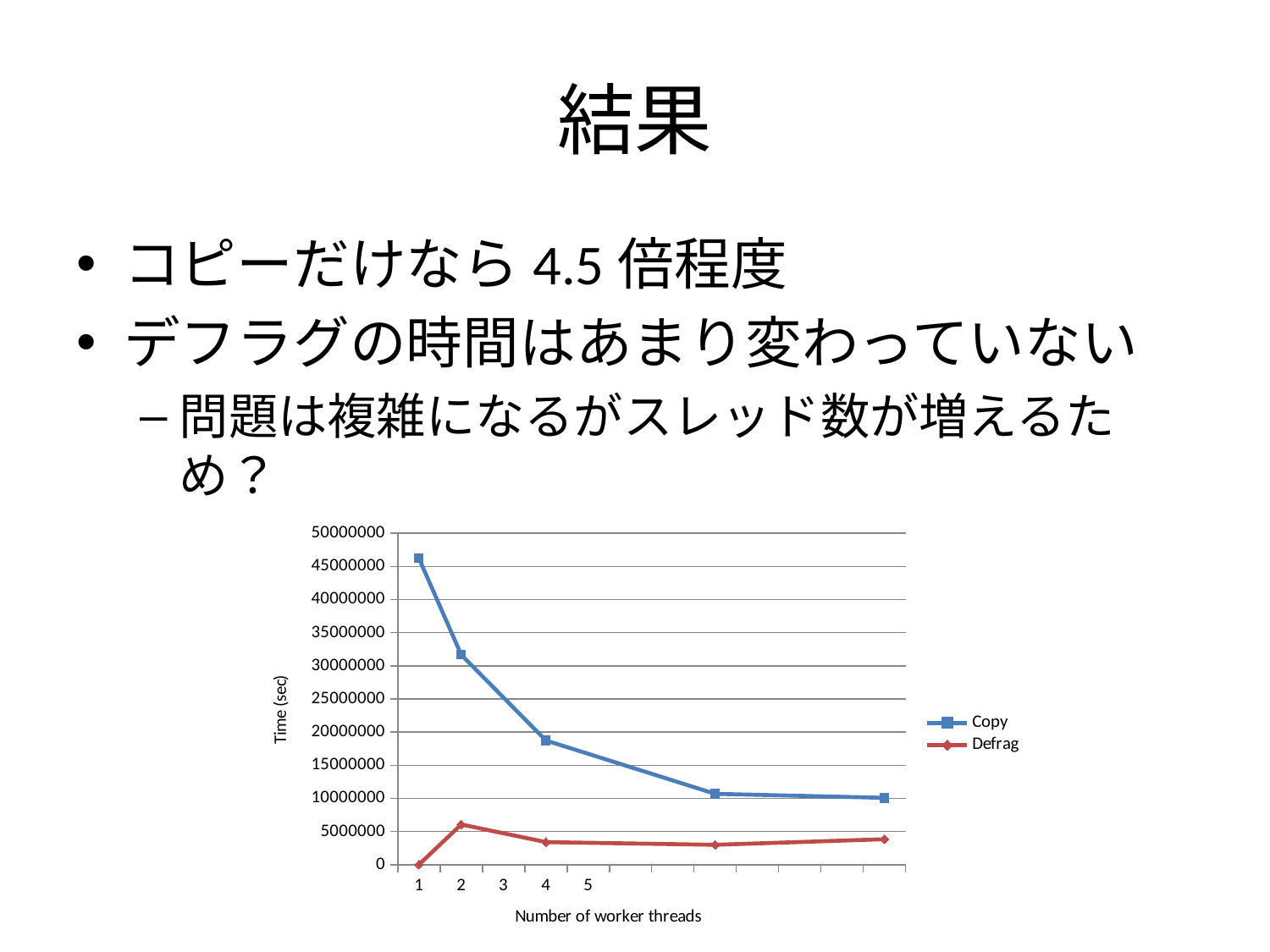
What are the two series named in the chart legend? Copy and Defrag At 1 worker thread, which series has the larger time, Copy or Defrag? Copy Is the Copy time at 1 worker thread greater or less than 40000000? greater At which number of worker threads is the Copy time highest? 1 Does the Copy time rise or fall as the number of worker threads increases? fall What kind of chart is shown on the slide? line chart How many data points does the Copy series have? 5 How many series does the chart legend list? 2 Is the Copy time at 4 worker threads greater or less than 20000000? less Is the Defrag time at 2 worker threads greater or less than 5000000? greater What is the label of the chart's x axis? Number of worker threads